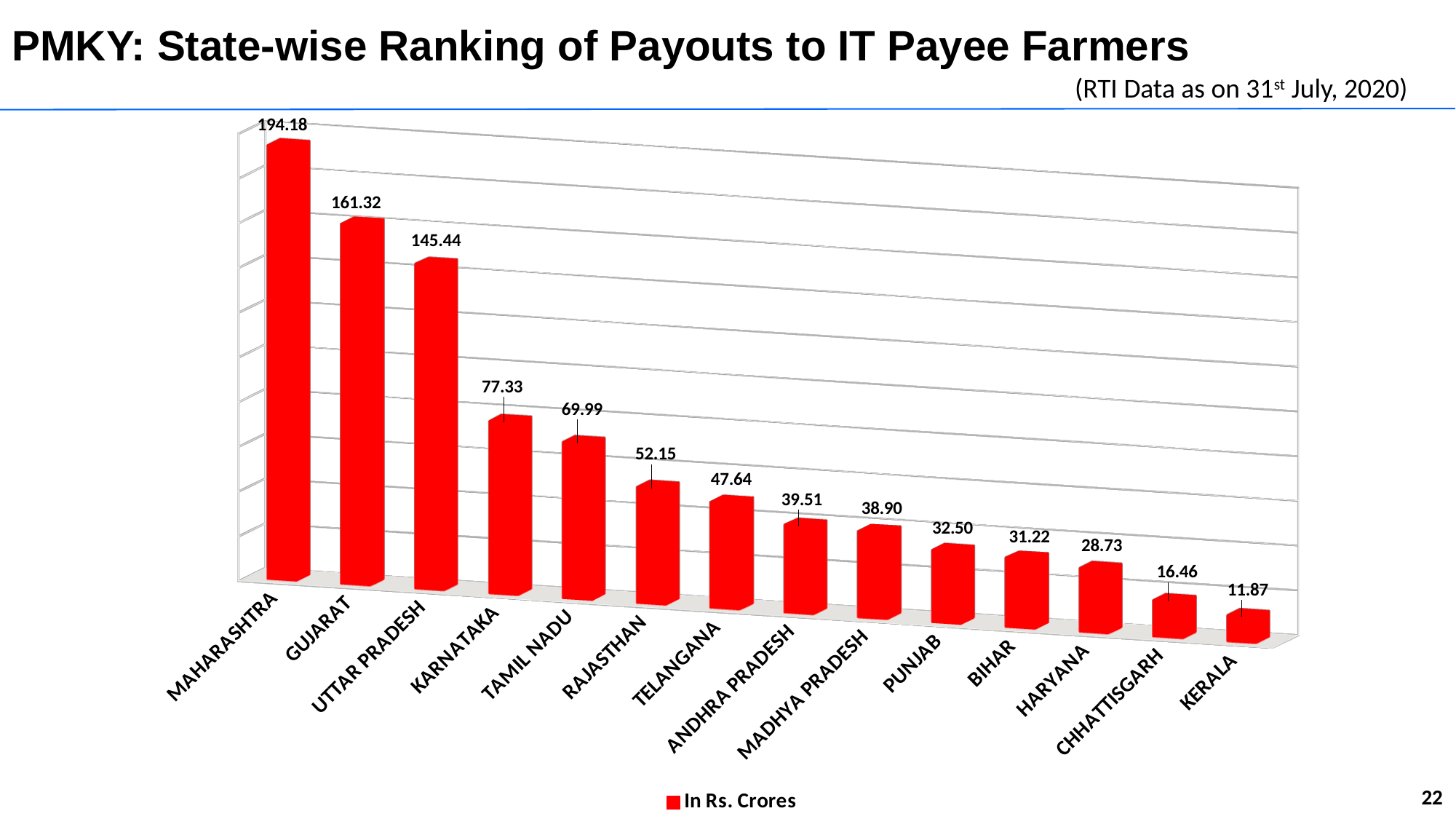
What is the difference between the values for Gujarat and Uttar Pradesh? 15.88 What is the value for Tamil Nadu? 69.99 Which state has the highest value? Maharashtra What is the value for Maharashtra? 194.18 Do the values rise or fall from left to right along the x axis? Fall What is the value for Chhattisgarh? 16.46 How many series does the legend list? 1 Which is larger, the value for Punjab or the value for Bihar? Punjab What unit does the legend give for the values? In Rs. Crores How many states are shown in the chart? 14 What kind of chart is shown on the slide? Bar chart Which state has the lowest value? Kerala